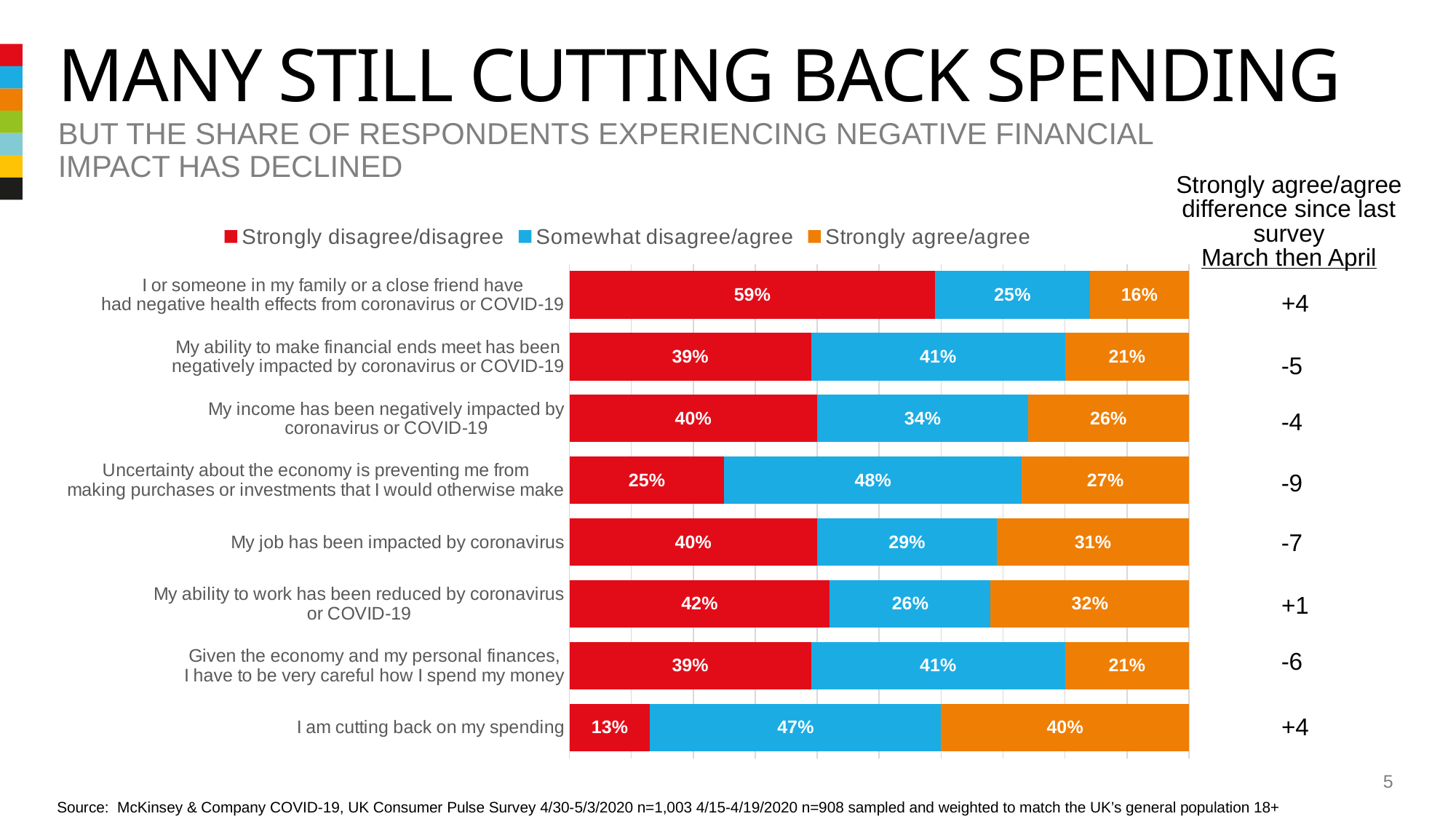
What is the Somewhat disagree/agree value for "Uncertainty about the economy is preventing me from making purchases or investments that I would otherwise make"? 48% What percentage of respondents strongly agree/agree with "I am cutting back on my spending"? 40% What is the difference between the Strongly agree/agree values for "My ability to work has been reduced by coronavirus or COVID-19" and "My income has been negatively impacted by coronavirus or COVID-19"? 6 percentage points How many statements (categories) are shown in the chart? 8 Which colour represents Strongly agree/agree in the legend? Orange Which is larger: the Strongly disagree/disagree share for "My job has been impacted by coronavirus" or for "Uncertainty about the economy is preventing me from making purchases or investments that I would otherwise make"? My job has been impacted by coronavirus What kind of chart is shown on the slide? Stacked bar chart Which statement has the highest Strongly agree/agree share? I am cutting back on my spending How many series does the legend list? 3 Which statement has the lowest Strongly disagree/disagree share? I am cutting back on my spending What percentage of respondents strongly disagree/disagree with "I or someone in my family or a close friend have had negative health effects from coronavirus or COVID-19"? 59% What is the total of the three segments for "My job has been impacted by coronavirus"? 100%